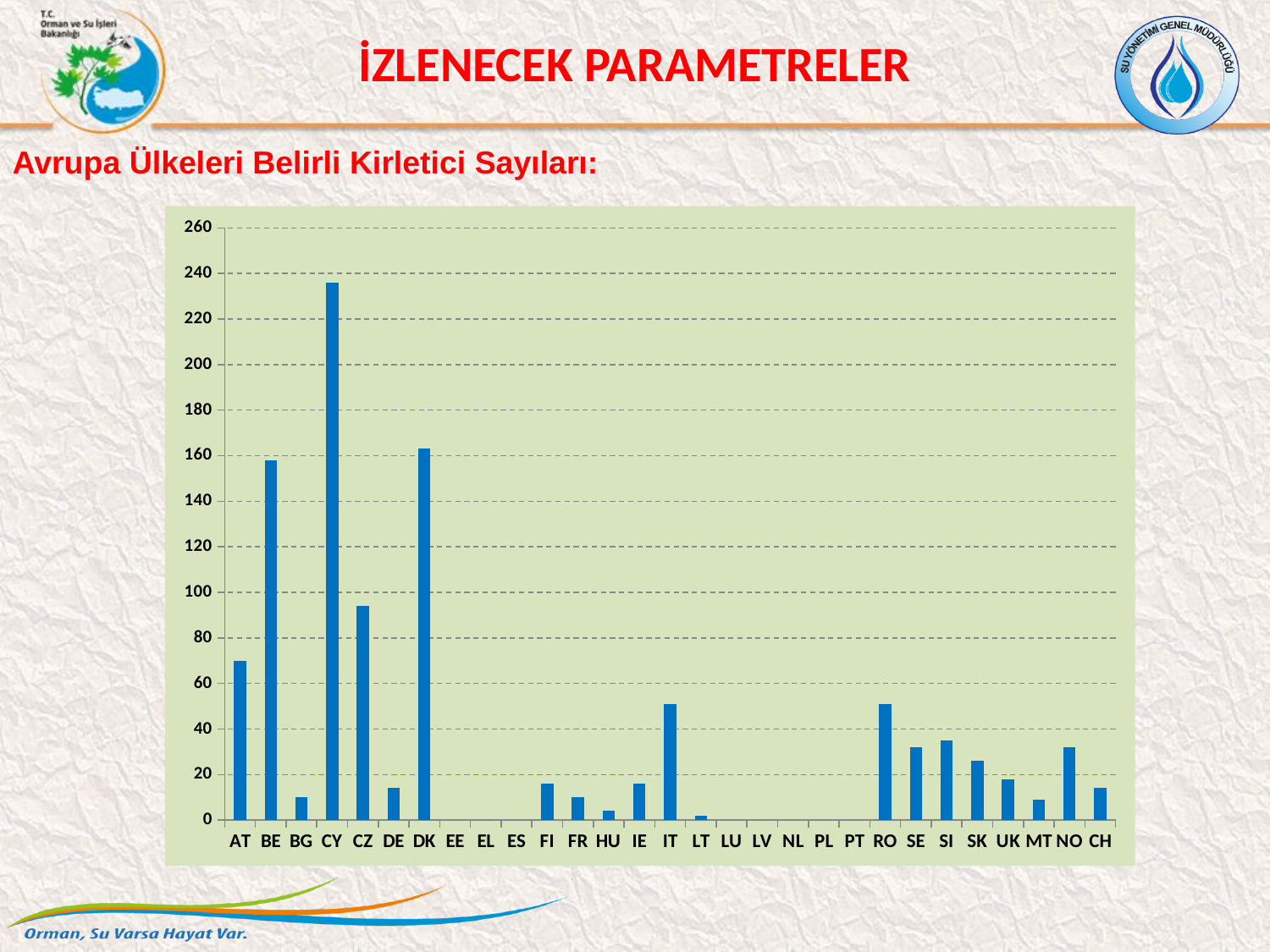
Is the value for CZ greater or less than 100? less Which has a larger value, CZ or AT? CZ Which has a larger value, DK or IT? DK What is the heading printed above the chart? Avrupa Ülkeleri Belirli Kirletici Sayıları: Which country has the highest value in the chart? CY Is the value for IT greater or less than 40? greater What kind of chart is shown on the slide? bar chart Is the value for CY greater or less than 220? greater How many country categories are shown on the x axis? 29